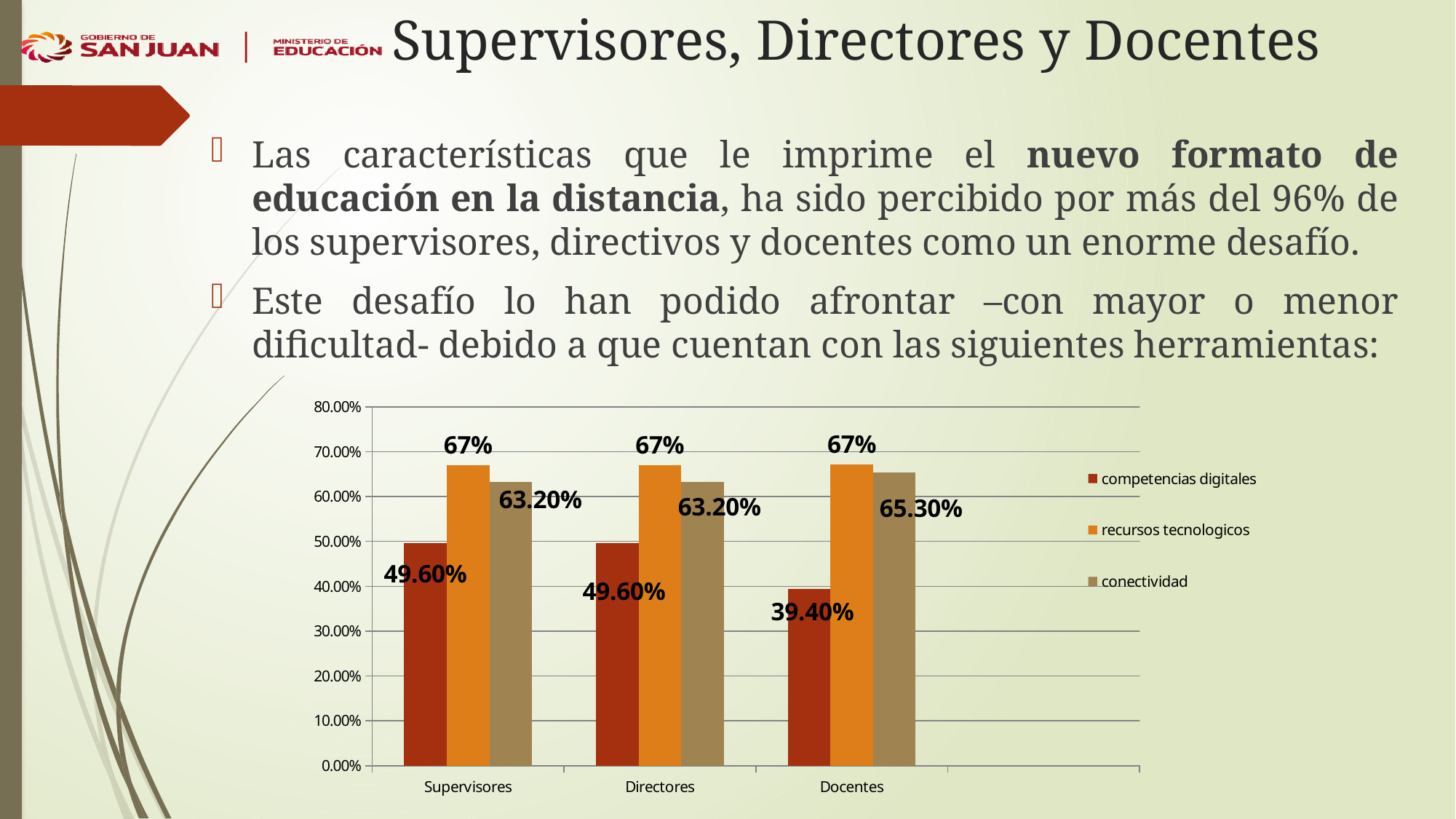
Which category has the highest value for conectividad? Docentes How many series does the legend list? 3 What is the value for conectividad for Supervisores? 63.20% Which is larger for Supervisores: recursos tecnologicos or conectividad? recursos tecnologicos What is the value for competencias digitales for Docentes? 39.40% What kind of chart is shown on the slide? bar chart What is the value for conectividad for Docentes? 65.30% How many categories are shown on the x axis? 3 What is the difference between the conectividad values for Docentes and Directores? 2.10% What is the value for recursos tecnologicos for Directores? 67% What is the difference between the recursos tecnologicos value and the competencias digitales value for Docentes? 27.60% Which category has the lowest value for competencias digitales? Docentes